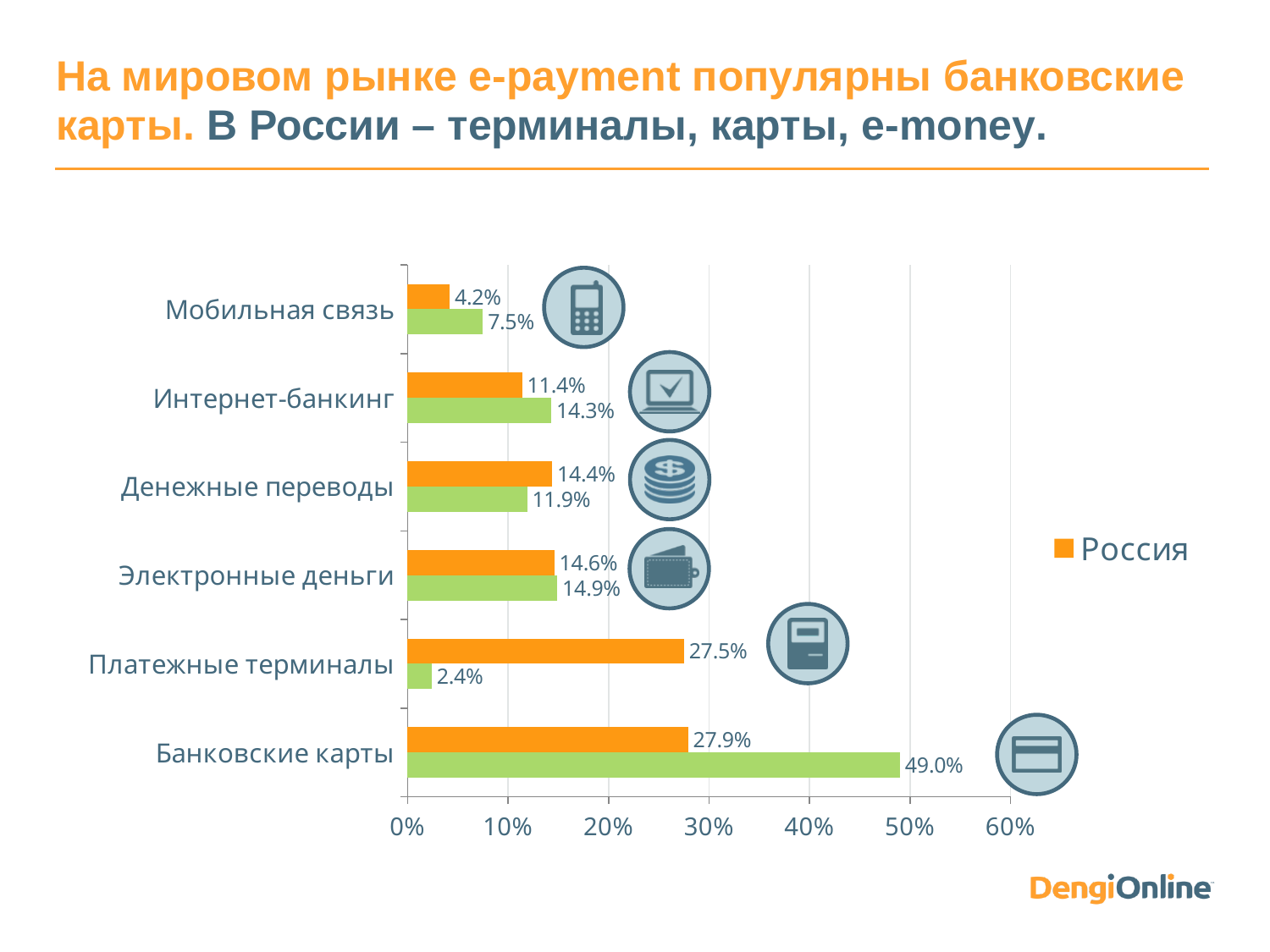
Which category has the lowest value for Россия? Мобильная связь Which category has the highest value for Россия? Банковские карты What series name does the legend list? Россия For Банковские карты, what is the difference between the green bar (49.0%) and the Россия bar (27.9%)? 21.1 percentage points What is the value of the green bar for Платежные терминалы? 2.4% How many categories are shown on the chart? 6 Is the green bar for Банковские карты greater or less than 40%? greater For Денежные переводы, which is larger: the Россия bar or the green bar? Россия What kind of chart is shown on the slide? Bar chart What is the value for Россия for Платежные терминалы? 27.5% What is the value of the green bar for Банковские карты? 49.0% What is the value for Россия for Мобильная связь? 4.2%